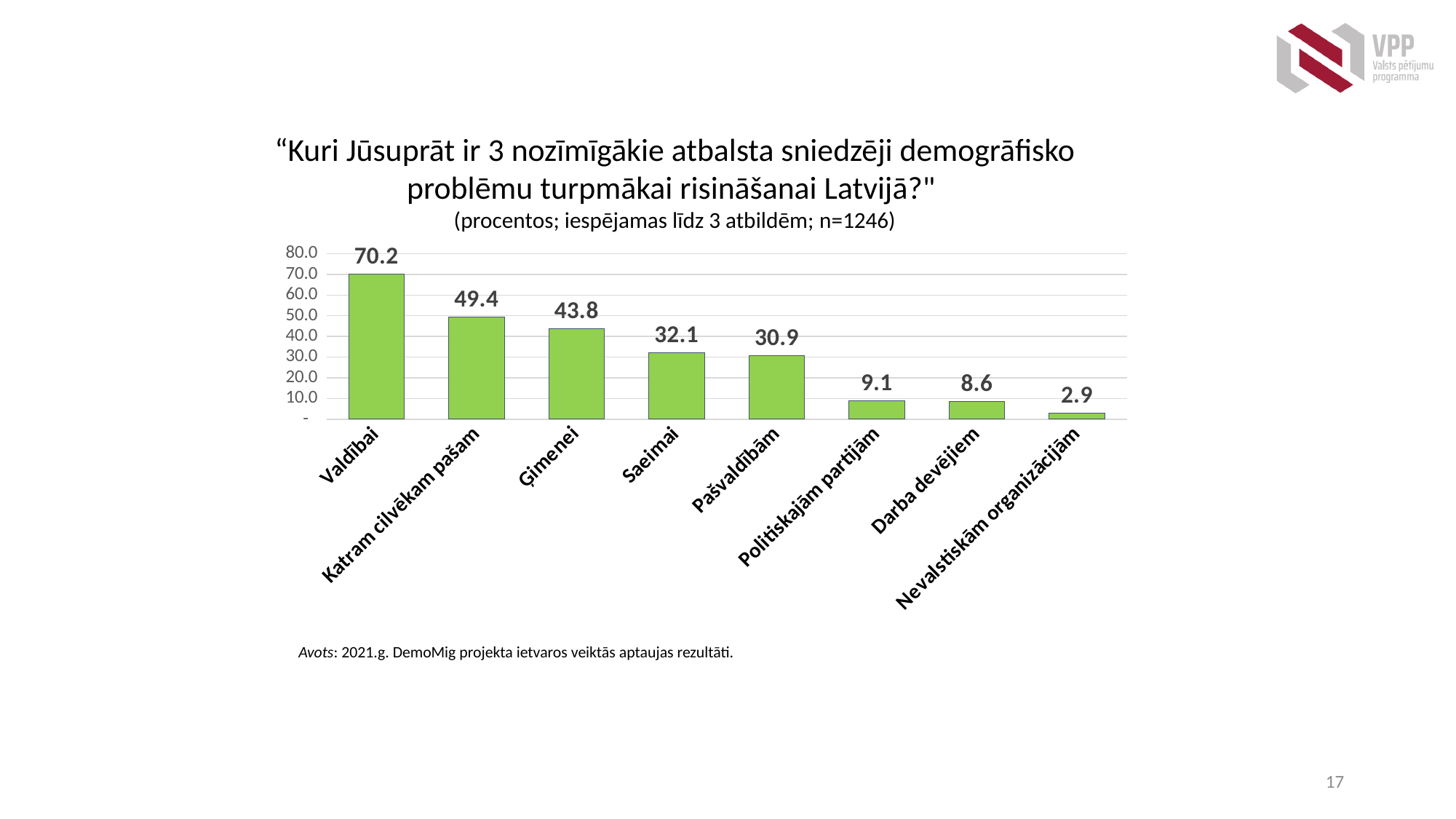
What is the value for Darba devējiem? 8.6 What is the value for Valdībai? 70.2 Is the value for Politiskajām partijām greater or less than 10.0? less How many categories are shown in the chart? 8 Which category has the highest value? Valdībai What is the difference between the values for Valdībai and Katram cilvēkam pašam? 20.8 What is the difference between the values for Saeimai and Pašvaldībām? 1.2 Which is larger, the value for Ģimenei or the value for Saeimai? Ģimenei Do the values rise or fall from left to right along the x axis? fall What kind of chart is shown on the slide? bar chart Which category has the lowest value? Nevalstiskām organizācijām What is the value for Ģimenei? 43.8